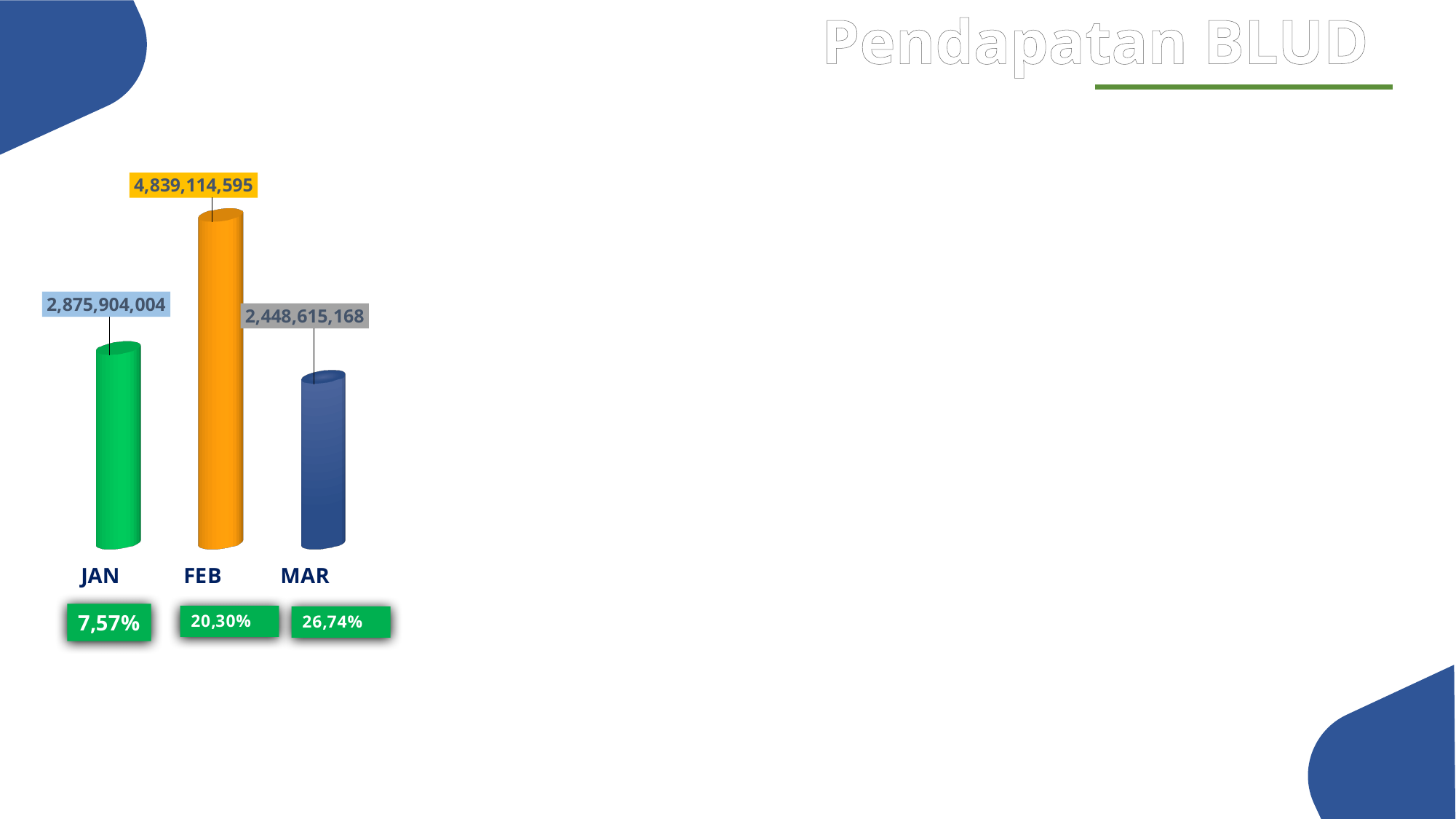
What is the title of the slide? Pendapatan BLUD What is the value for FEB? 4,839,114,595 What is the difference between the values for FEB and JAN? 1,963,210,591 What is the value for JAN? 2,875,904,004 What is the difference between the values for JAN and MAR? 427,288,836 Does the value rise or fall from FEB to MAR? fall Which is larger, the value for JAN or the value for MAR? JAN How many months are shown in the chart? 3 What is the value for MAR? 2,448,615,168 What kind of chart is shown on the slide? bar chart Which month has the highest value? FEB Which month has the lowest value? MAR